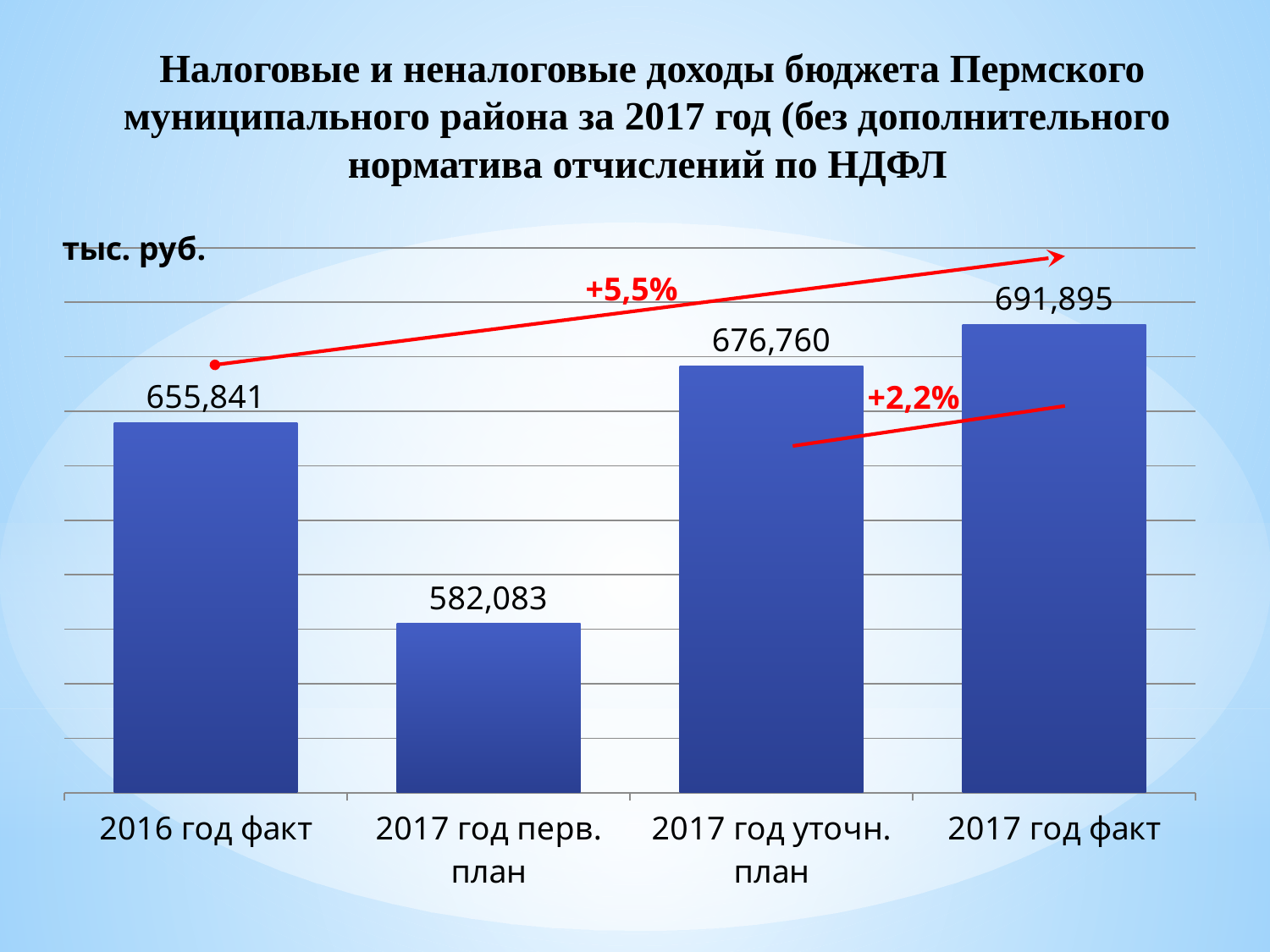
What is the difference between the values for 2017 год уточн. план and 2017 год перв. план? 94,677 What is the value for 2017 год факт? 691,895 Which category has the lowest value? 2017 год перв. план Which category has the highest value? 2017 год факт What kind of chart is shown on the slide? bar chart What is the difference between the values for 2017 год факт and 2016 год факт? 36,054 What is the value for 2017 год перв. план? 582,083 What is the value for 2017 год уточн. план? 676,760 What is the value for 2016 год факт? 655,841 Which is larger, the value for 2016 год факт or the value for 2017 год уточн. план? 2017 год уточн. план How many categories are shown in the chart? 4 What percentage change is annotated between 2016 год факт and 2017 год факт? +5,5%